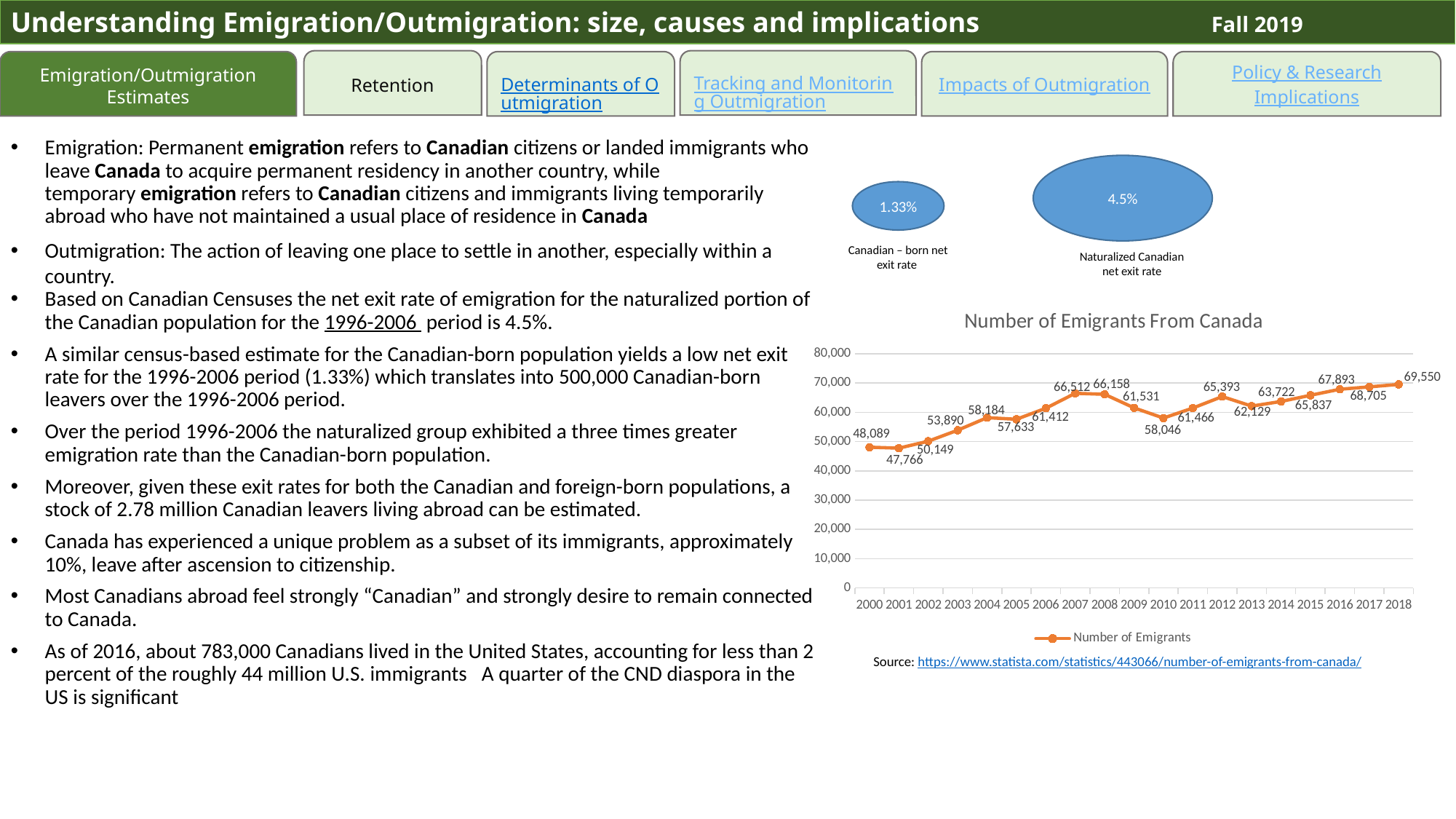
In the 'Number of Emigrants From Canada' chart, which year has the highest number of emigrants? 2018 In the 'Number of Emigrants From Canada' chart, what is the difference between the values for 2018 and 2000? 21,461 In the 'Number of Emigrants From Canada' chart, what is the difference between the values for 2007 and 2006? 5,100 In the 'Number of Emigrants From Canada' chart, which year has the lowest number of emigrants? 2001 How many years are plotted in the 'Number of Emigrants From Canada' chart? 19 In the 'Number of Emigrants From Canada' chart, what is the value for 2018? 69,550 In the 'Number of Emigrants From Canada' chart, what is the value for 2010? 58,046 What type of chart is 'Number of Emigrants From Canada'? line chart In the 'Number of Emigrants From Canada' chart, what is the value for 2000? 48,089 How many series does the legend of the 'Number of Emigrants From Canada' chart list? 1 In the 'Number of Emigrants From Canada' chart, is the value for 2010 greater or less than 60,000? less In the 'Number of Emigrants From Canada' chart, which year has a larger value, 2007 or 2012? 2007